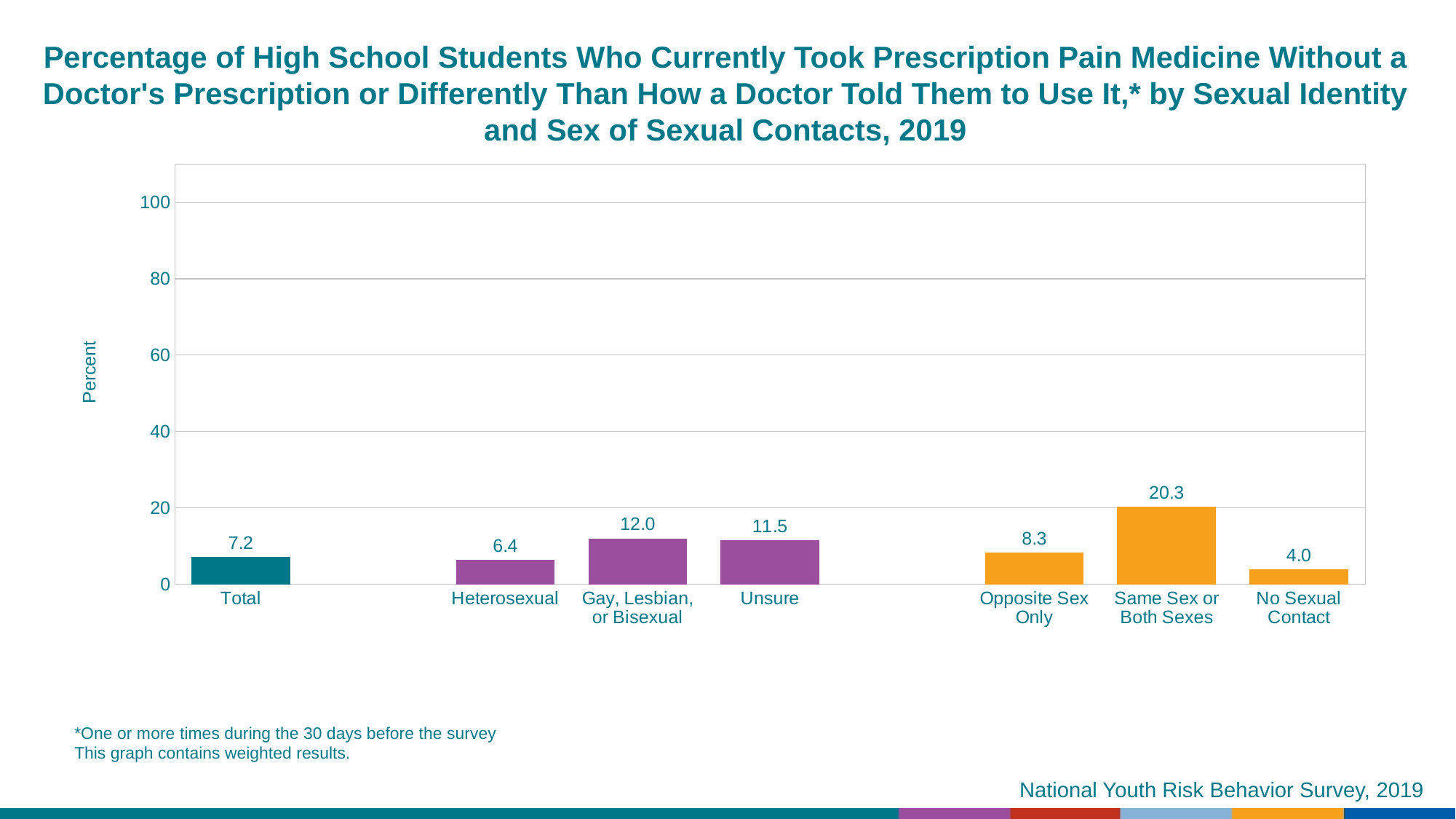
What is the difference between the values for Gay, Lesbian, or Bisexual and Heterosexual? 5.6 What is the value for Total? 7.2 Which category has the highest value? Same Sex or Both Sexes What is the label of the y axis? Percent What is the value for No Sexual Contact? 4.0 What kind of chart is shown on the slide? bar chart Which category has the lowest value? No Sexual Contact What is the value for Same Sex or Both Sexes? 20.3 Which is larger, the value for Opposite Sex Only or the value for Unsure? Unsure What is the value for Heterosexual students? 6.4 Is the value for Same Sex or Both Sexes greater or less than 20? greater How many categories are shown on the x axis? 7